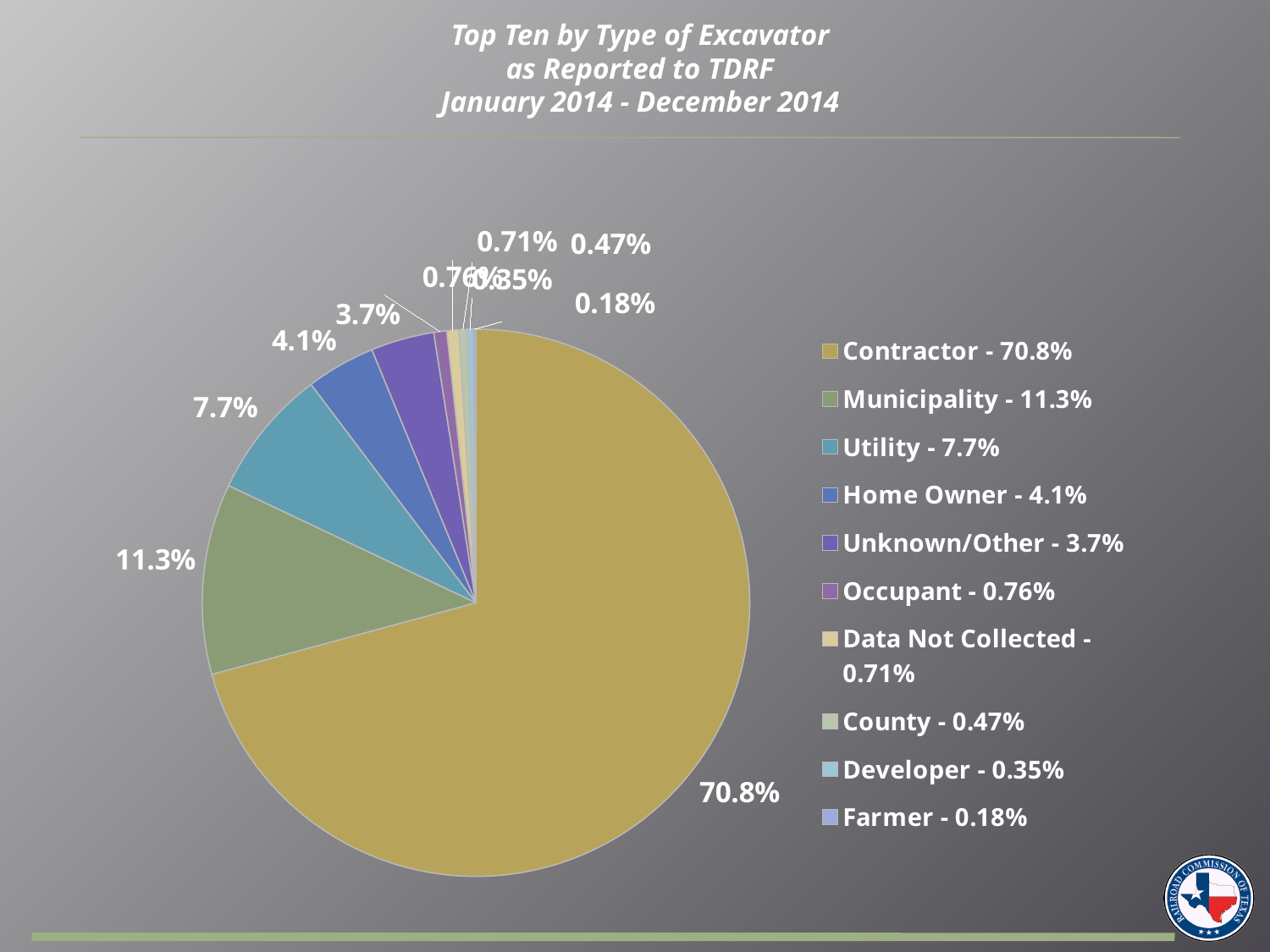
How many categories does the legend list? 10 What kind of chart is shown on the slide? Pie chart Which type of excavator has the smallest share? Farmer What is the value for Data Not Collected? 0.71% Which type of excavator has the largest share? Contractor What share of the pie does Contractor account for? 70.8% What is the difference between the Municipality and Utility shares? 3.6% What is the value for Municipality? 11.3% What is the combined share of Contractor and Municipality? 82.1% What is the title of the chart? Top Ten by Type of Excavator as Reported to TDRF January 2014 - December 2014 Which is larger, the share for Utility or the share for Unknown/Other? Utility What is the value for Home Owner? 4.1%